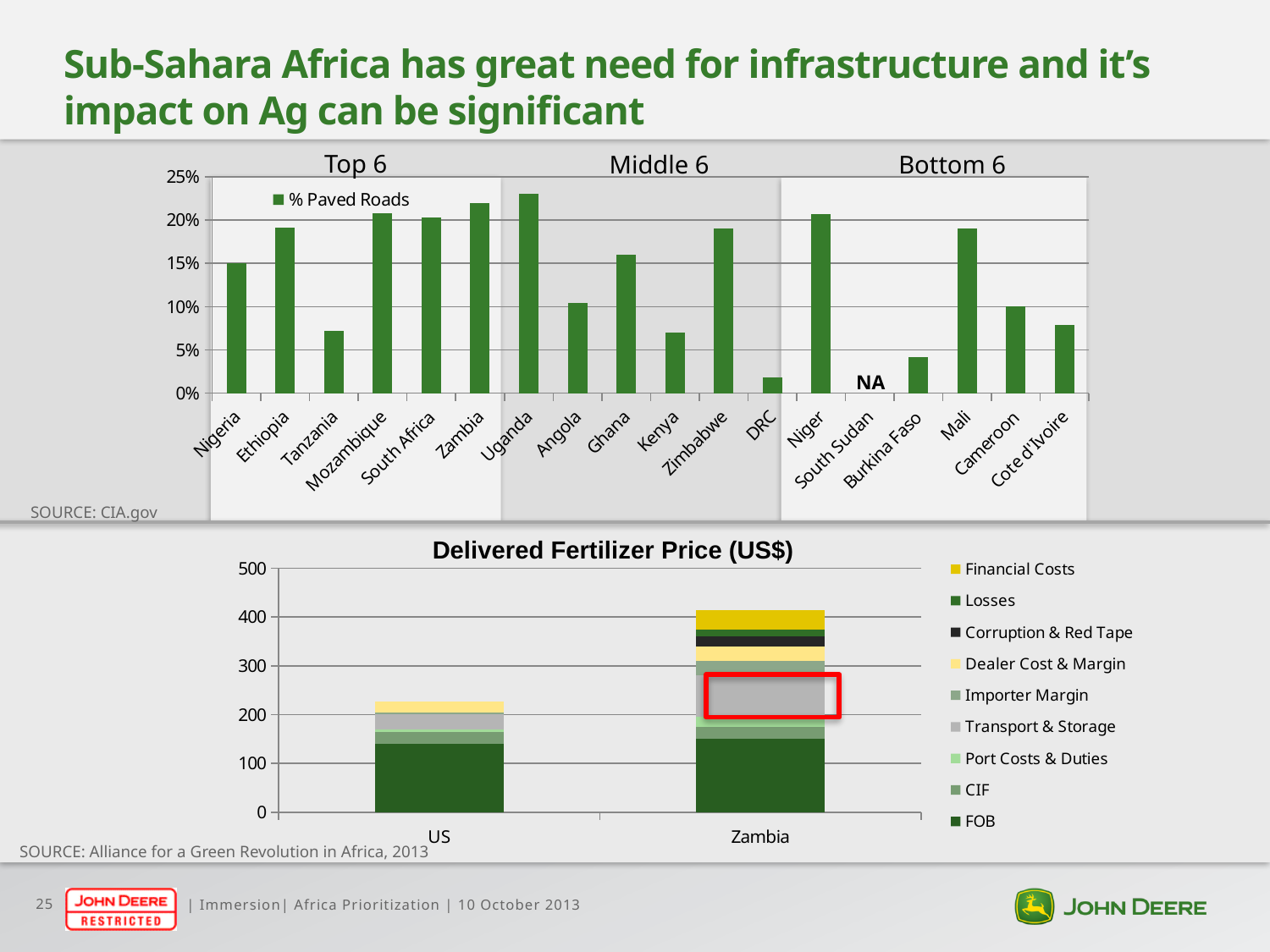
In the Delivered Fertilizer Price (US$) chart, which country has the higher total delivered fertilizer price, US or Zambia? Zambia In the top chart, which country with a plotted bar has the lowest % Paved Roads? DRC In the top chart, is the % Paved Roads value for Tanzania greater or less than 10%? less In the Delivered Fertilizer Price (US$) chart, how many series does the legend list? 9 In the top chart, is the % Paved Roads value for Burkina Faso greater or less than 5%? less In the top chart, is the % Paved Roads value for Mali greater or less than 15%? greater What kind of chart is the Delivered Fertilizer Price (US$) chart? Stacked bar chart In the top chart, which has a higher % Paved Roads, Uganda or Angola? Uganda In the top chart, which country has the highest % Paved Roads? Uganda In the top chart, how many countries are listed on the x axis? 18 In the top chart, which country is marked NA instead of having a bar? South Sudan